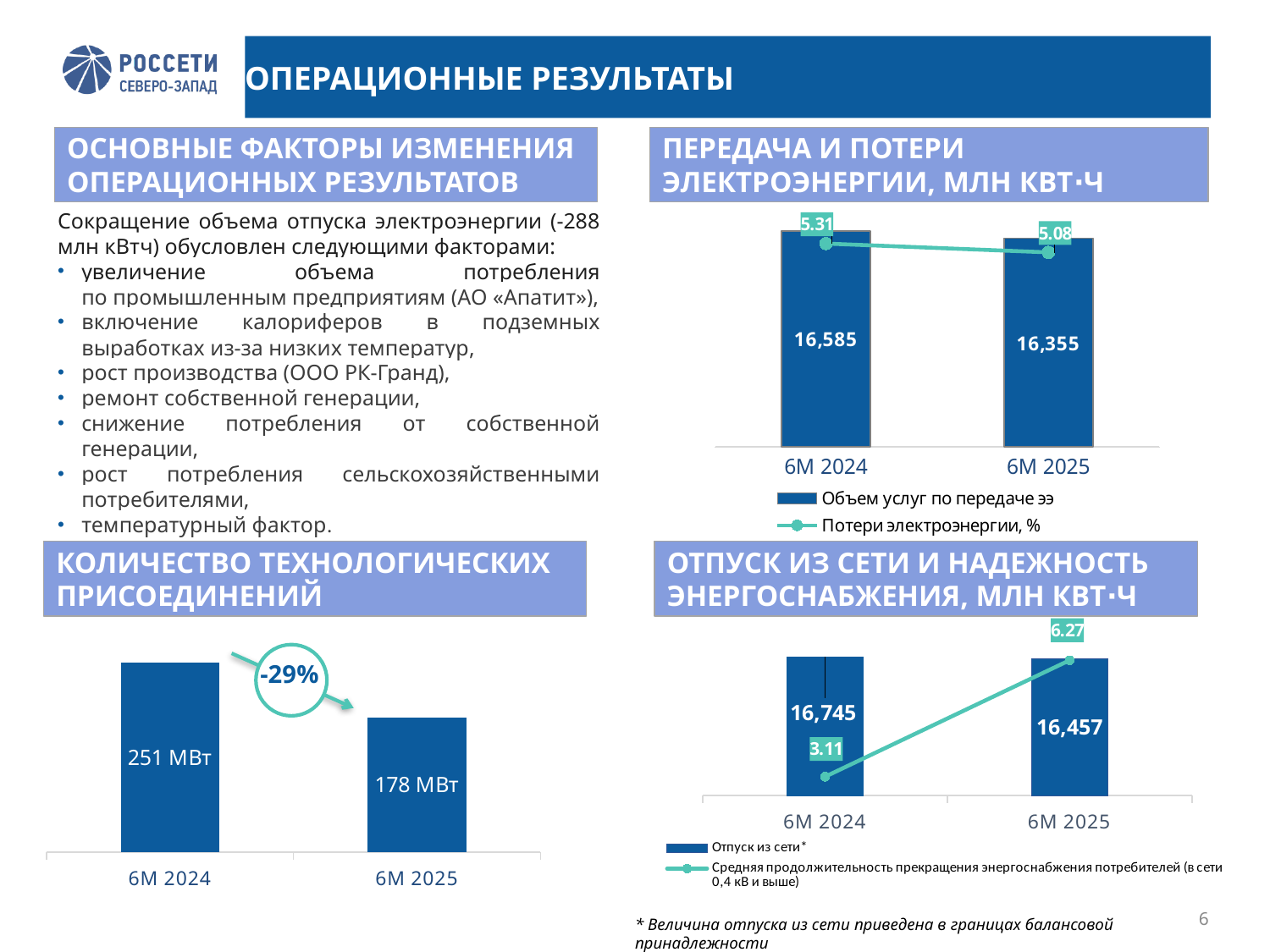
What kind of chart is 'КОЛИЧЕСТВО ТЕХНОЛОГИЧЕСКИХ ПРИСОЕДИНЕНИЙ'? bar chart In the chart 'КОЛИЧЕСТВО ТЕХНОЛОГИЧЕСКИХ ПРИСОЕДИНЕНИЙ', what is the value for 6M 2025? 178 МВт In the chart 'ОТПУСК ИЗ СЕТИ И НАДЕЖНОСТЬ ЭНЕРГОСНАБЖЕНИЯ, МЛН КВТ·Ч', what is the value of 'Отпуск из сети' for 6M 2025? 16,457 In the chart 'ПЕРЕДАЧА И ПОТЕРИ ЭЛЕКТРОЭНЕРГИИ, МЛН КВТ·Ч', how many series does the legend list? 2 In the chart 'ПЕРЕДАЧА И ПОТЕРИ ЭЛЕКТРОЭНЕРГИИ, МЛН КВТ·Ч', what is the value of 'Потери электроэнергии, %' for 6M 2025? 5.08 In the chart 'ПЕРЕДАЧА И ПОТЕРИ ЭЛЕКТРОЭНЕРГИИ, МЛН КВТ·Ч', does 'Потери электроэнергии, %' rise or fall from 6M 2024 to 6M 2025? fall In the chart 'ПЕРЕДАЧА И ПОТЕРИ ЭЛЕКТРОЭНЕРГИИ, МЛН КВТ·Ч', by how much did 'Объем услуг по передаче ээ' decrease from 6M 2024 to 6M 2025? 230 In the chart 'ОТПУСК ИЗ СЕТИ И НАДЕЖНОСТЬ ЭНЕРГОСНАБЖЕНИЯ, МЛН КВТ·Ч', by how much did the average duration of supply interruption (line series) increase from 6M 2024 to 6M 2025? 3.16 In the chart 'ОТПУСК ИЗ СЕТИ И НАДЕЖНОСТЬ ЭНЕРГОСНАБЖЕНИЯ, МЛН КВТ·Ч', which period has the higher value of 'Отпуск из сети', 6M 2024 or 6M 2025? 6M 2024 In the chart 'КОЛИЧЕСТВО ТЕХНОЛОГИЧЕСКИХ ПРИСОЕДИНЕНИЙ', what is the difference between the 6M 2024 and 6M 2025 values? 73 МВт In the chart 'КОЛИЧЕСТВО ТЕХНОЛОГИЧЕСКИХ ПРИСОЕДИНЕНИЙ', what percentage change is shown between 6M 2024 and 6M 2025? -29% In the chart 'ПЕРЕДАЧА И ПОТЕРИ ЭЛЕКТРОЭНЕРГИИ, МЛН КВТ·Ч', what is the value of 'Объем услуг по передаче ээ' for 6M 2024? 16,585